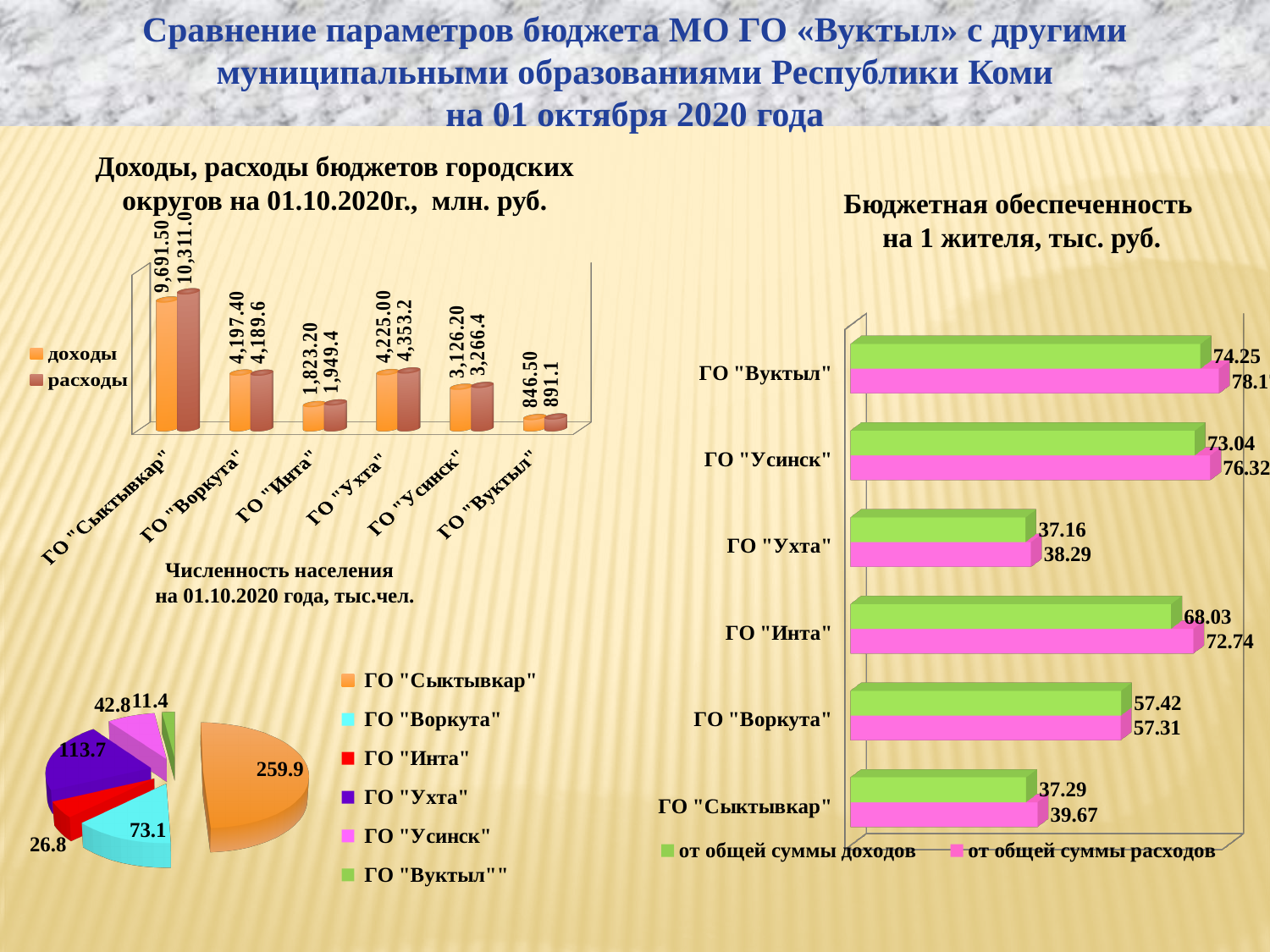
In the chart 'Доходы, расходы бюджетов городских округов на 01.10.2020г., млн. руб.', what is the value of расходы for ГО "Вуктыл"? 891.1 In the chart 'Бюджетная обеспеченность на 1 жителя, тыс. руб.', which city district has the highest value 'от общей суммы доходов'? ГО "Вуктыл" In the chart 'Доходы, расходы бюджетов городских округов на 01.10.2020г., млн. руб.', what kind of chart is it? Bar chart In the chart 'Доходы, расходы бюджетов городских округов на 01.10.2020г., млн. руб.', how many series does the legend list? 2 In the chart 'Доходы, расходы бюджетов городских округов на 01.10.2020г., млн. руб.', what is the value of доходы for ГО "Сыктывкар"? 9,691.50 In the pie chart 'Численность населения на 01.10.2020 года, тыс.чел.', how many slices are there? 6 In the chart 'Бюджетная обеспеченность на 1 жителя, тыс. руб.', what is the difference between 'от общей суммы расходов' and 'от общей суммы доходов' for ГО "Усинск"? 3.28 In the chart 'Бюджетная обеспеченность на 1 жителя, тыс. руб.', what is the value 'от общей суммы расходов' for ГО "Сыктывкар"? 39.67 In the pie chart 'Численность населения на 01.10.2020 года, тыс.чел.', which city district has the largest slice? ГО "Сыктывкар" In the pie chart 'Численность населения на 01.10.2020 года, тыс.чел.', what is the value for ГО "Ухта"? 113.7 In the chart 'Доходы, расходы бюджетов городских округов на 01.10.2020г., млн. руб.', which city district has the lowest доходы? ГО "Вуктыл" In the chart 'Бюджетная обеспеченность на 1 жителя, тыс. руб.', what is the value 'от общей суммы доходов' for ГО "Инта"? 68.03